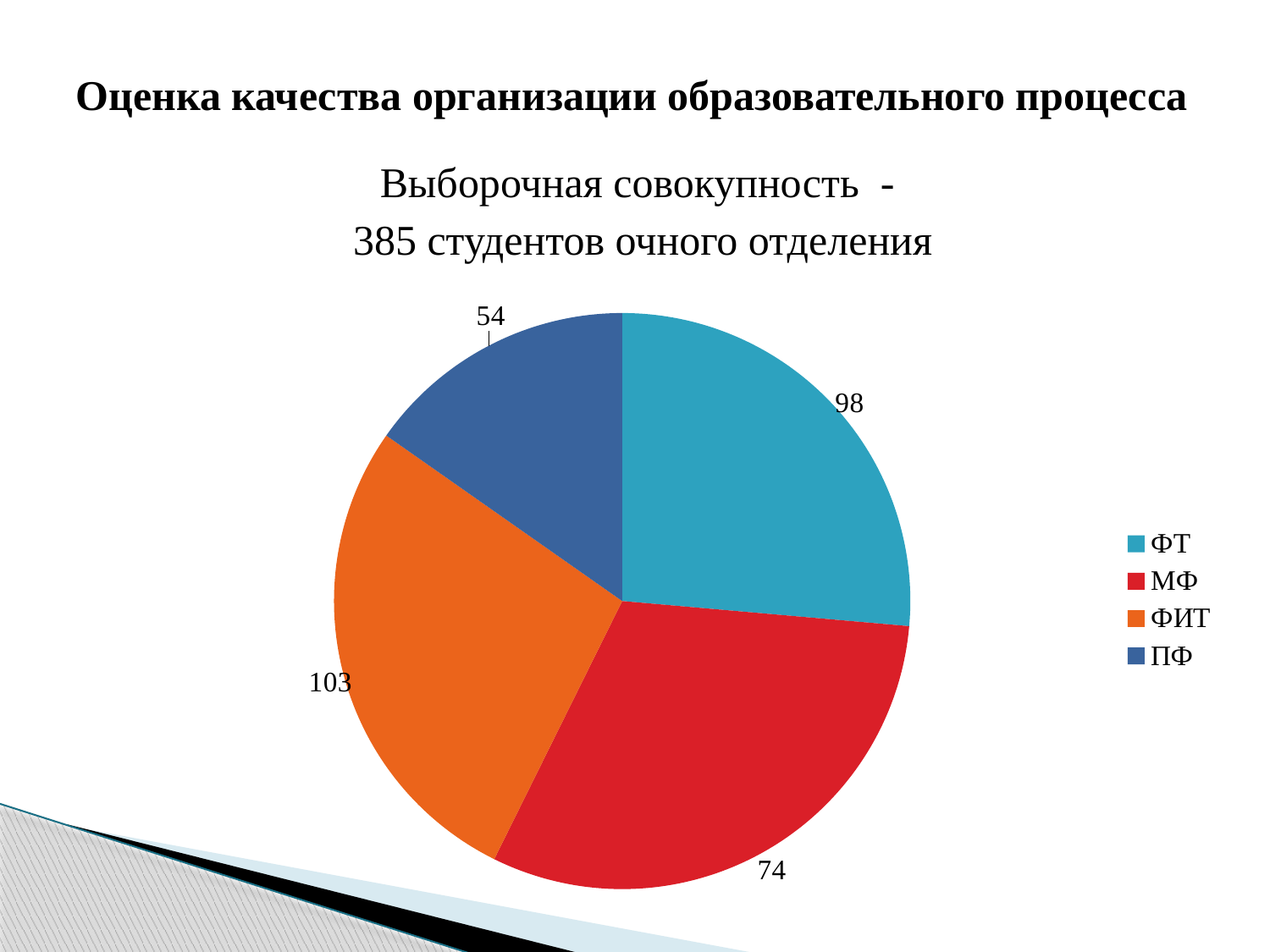
What is the difference between the values for ФТ and МФ? 24 What is the value for ФИТ in the pie chart? 103 What is the value for ПФ in the pie chart? 54 Which is larger, the value for ФТ or the value for ПФ? ФТ What is the value for МФ in the pie chart? 74 What kind of chart is shown on the slide? pie chart How many categories does the pie chart have? 4 What is the difference between the values for ФИТ and ПФ? 49 Which category has the smallest slice in the pie chart? ПФ What is the value for ФТ in the pie chart? 98